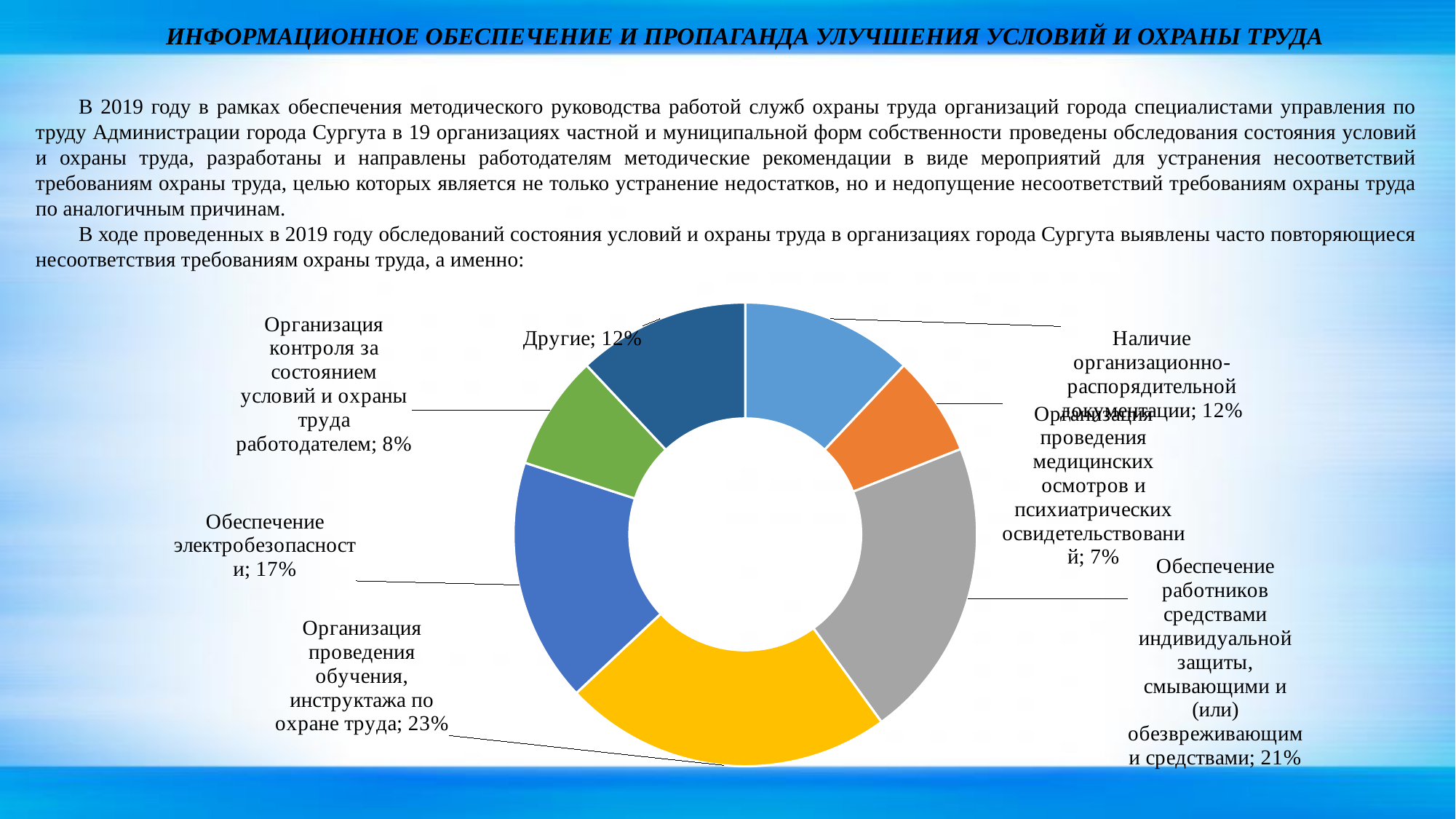
What kind of chart is shown on the slide? Doughnut (pie) chart What is the difference in percentage points between "Организация проведения обучения, инструктажа по охране труда" and "Обеспечение работников средствами индивидуальной защиты, смывающими и (или) обезвреживающими средствами"? 2 What share is shown for "Обеспечение электробезопасности"? 17% What colour is the slice for "Организация проведения обучения, инструктажа по охране труда"? Yellow Which category has the largest share in the chart? Организация проведения обучения, инструктажа по охране труда Which category has the smallest share in the chart? Организация проведения медицинских осмотров и психиатрических освидетельствований What share is shown for "Организация проведения медицинских осмотров и психиатрических освидетельствований"? 7% What share is shown for "Наличие организационно-распорядительной документации"? 12% Which is larger: the share for "Обеспечение электробезопасности" or the share for "Организация контроля за состоянием условий и охраны труда работодателем"? Обеспечение электробезопасности What share is shown for "Организация проведения обучения, инструктажа по охране труда"? 23% What share is shown for "Другие"? 12% How many slices does the doughnut chart have? 7